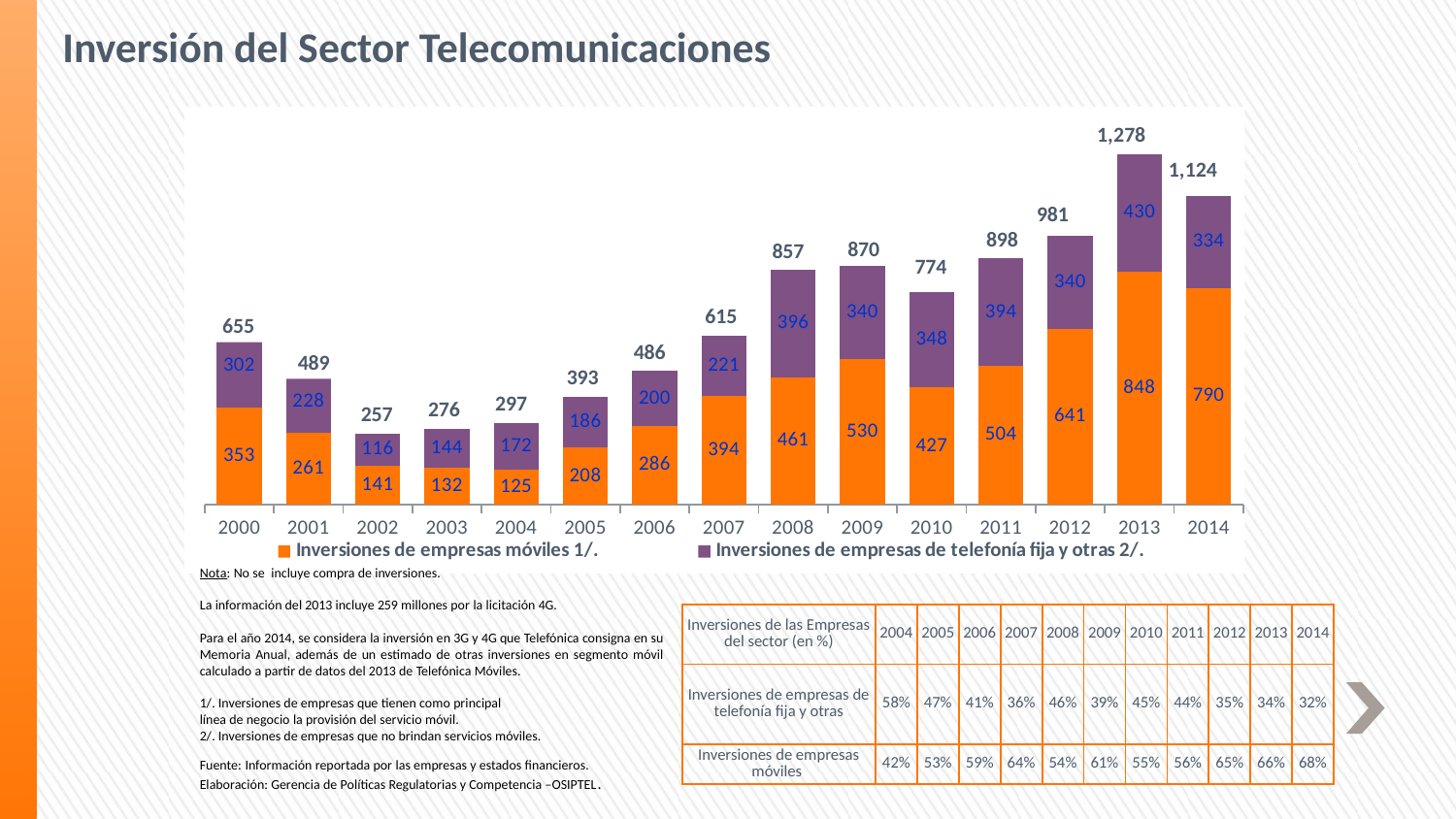
Which is larger in 2004: Inversiones de empresas móviles or Inversiones de empresas de telefonía fija y otras? Inversiones de empresas de telefonía fija y otras Which year has the highest total investment? 2013 Which colour represents Inversiones de empresas móviles in the chart? Orange What is the value for Inversiones de empresas móviles in 2013? 848 What is the total investment shown above the bar for 2014? 1,124 Which year has the lowest total investment? 2002 What kind of chart is shown on the slide? Stacked bar chart How many years are shown on the x axis of the chart? 15 What is the difference between the Inversiones de empresas móviles values for 2013 and 2014? 58 Do the total investment values rise or fall from 2002 to 2013? Rise How many series does the chart legend list? 2 What is the value for Inversiones de empresas de telefonía fija y otras in 2008? 396